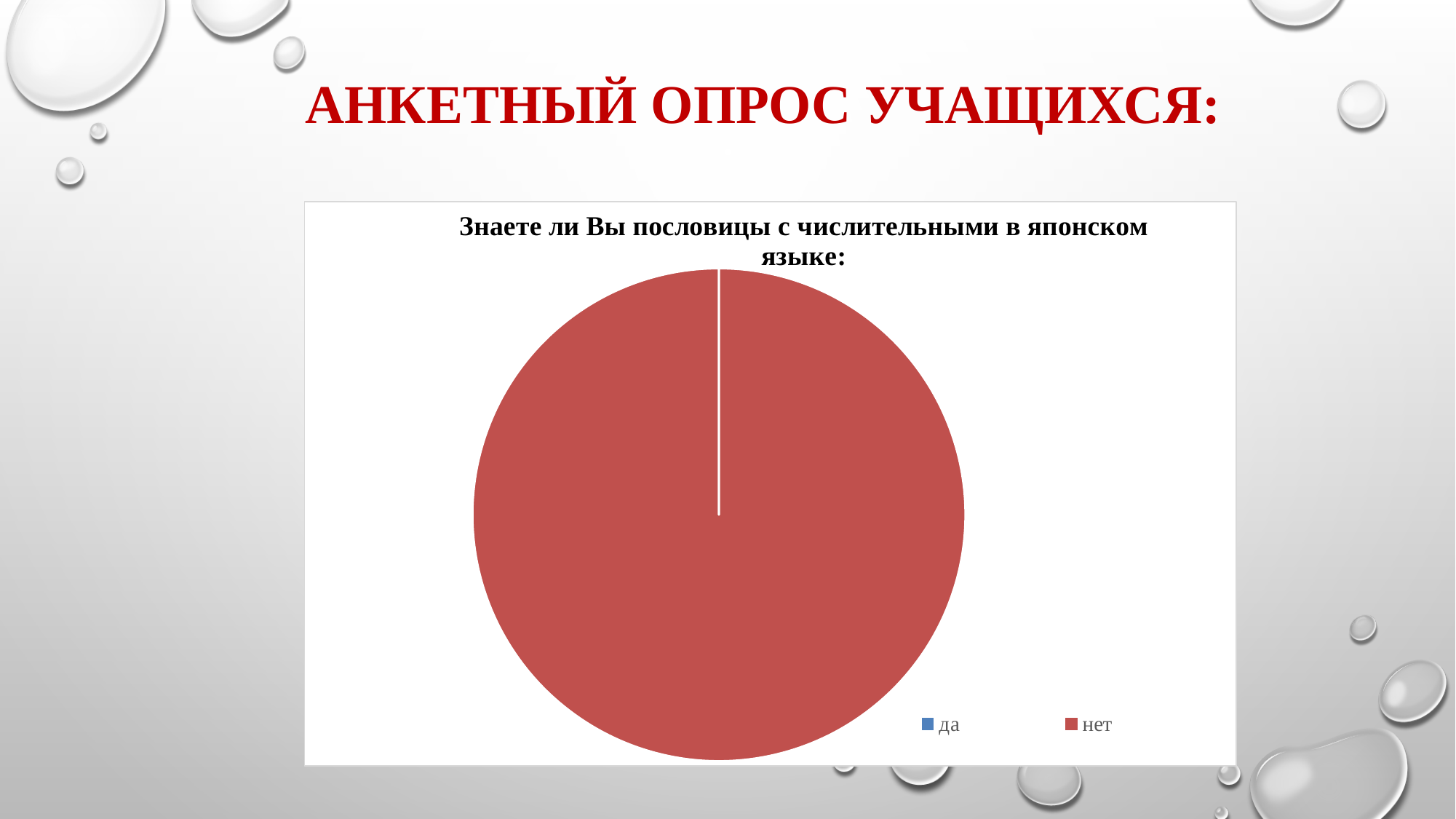
Which slice is larger, "да" or "нет"? нет What is the title of the chart? Знаете ли Вы пословицы с числительными в японском языке: Which category has the smallest slice of the pie? да What colour represents the "нет" category in the chart? red What kind of chart is shown on the slide? pie chart How many entries does the chart legend list? 2 Which category has the largest slice of the pie? нет